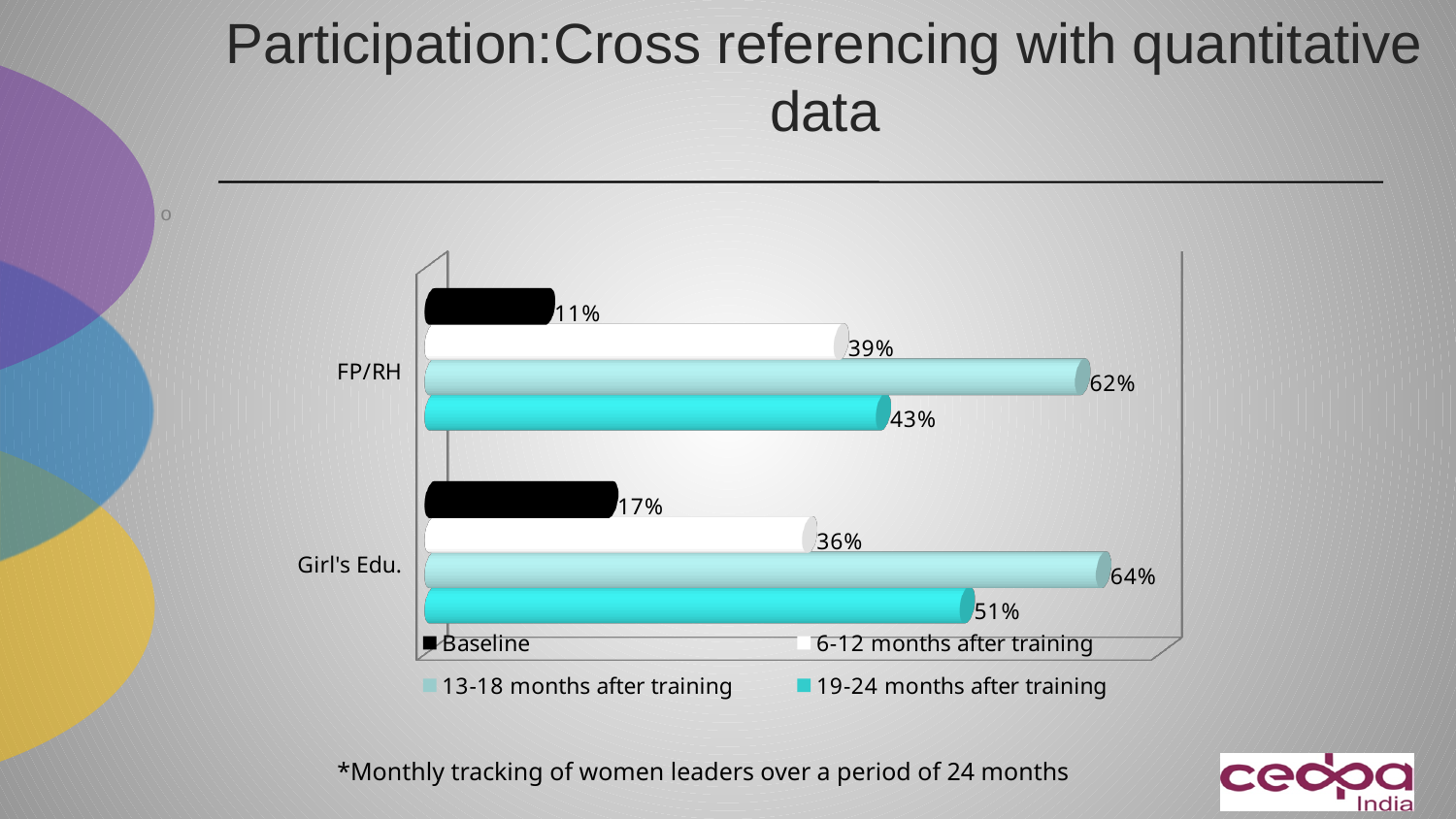
Which is larger: the 19-24 months after training value for Girl's Edu. or for FP/RH? Girl's Edu. What is the value for FP/RH at 19-24 months after training? 43% How many categories are shown on the chart? 2 What colour are the Baseline bars? Black What is the value for Girl's Edu. at 13-18 months after training? 64% Which series has the highest value for FP/RH? 13-18 months after training What kind of chart is shown on the slide? Bar chart Which series has the lowest value for Girl's Edu.? Baseline What is the Baseline value for FP/RH? 11% How many series does the legend list? 4 What is the difference between the 13-18 months after training value and the Baseline value for FP/RH? 51% What is the value for Girl's Edu. at 6-12 months after training? 36%